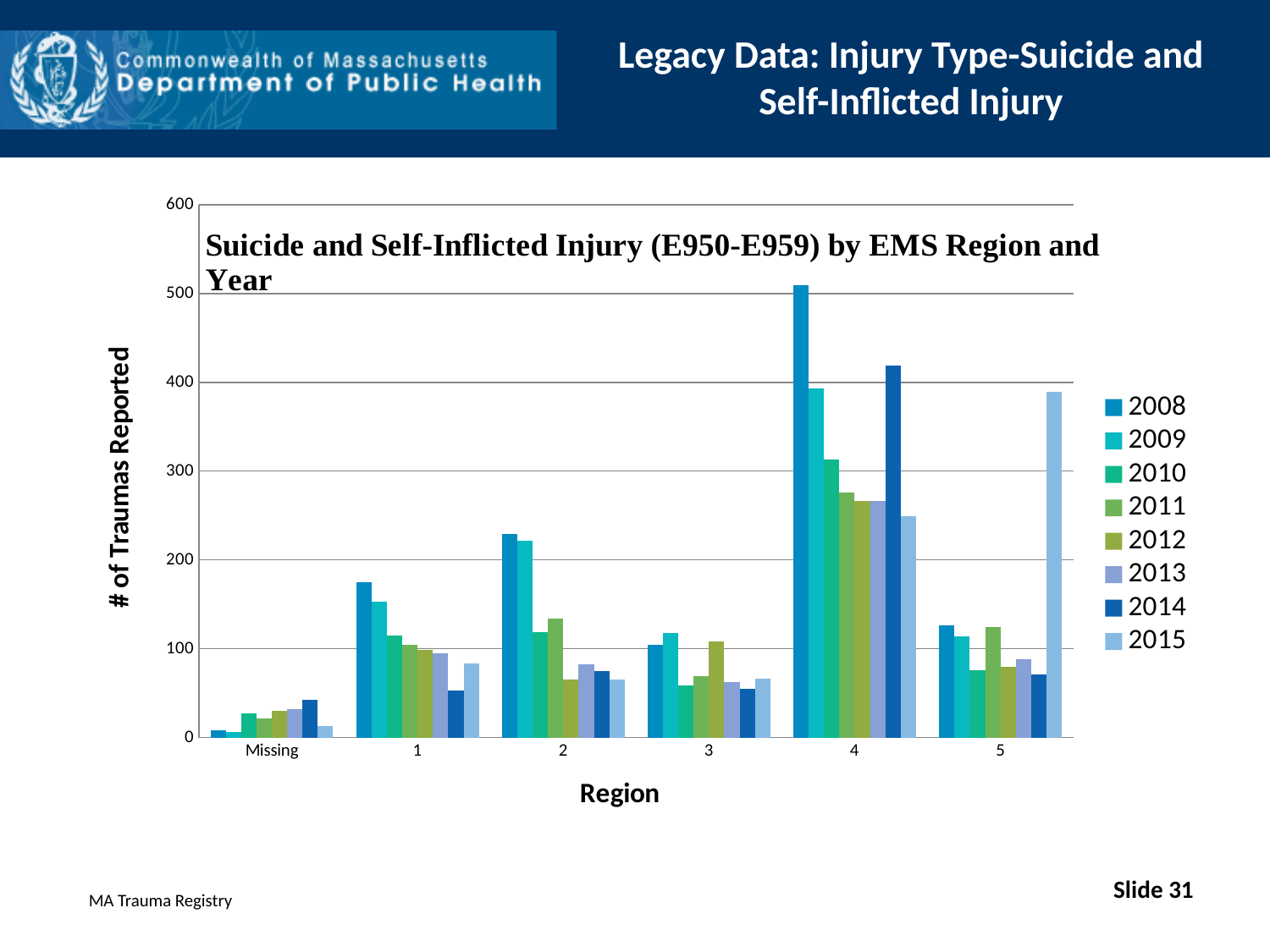
Which region has the highest number of traumas reported for 2008? 4 For Region 4, which is larger: the 2009 value or the 2014 value? 2014 How many region categories are shown on the x axis? 6 Which is larger for 2008: Region 1 or Region 2? Region 2 Is the 2015 value for Region 5 greater or less than 300? greater For Region 1, do the values rise or fall from 2008 through 2013? fall Is the 2008 value for Region 4 greater or less than 400? greater What kind of chart is shown on the slide? bar chart Is the 2008 value for Region 2 greater or less than 200? greater Which region has the lowest number of traumas reported for 2014? Missing How many series (years) does the legend list? 8 What is the title of the y axis? # of Traumas Reported